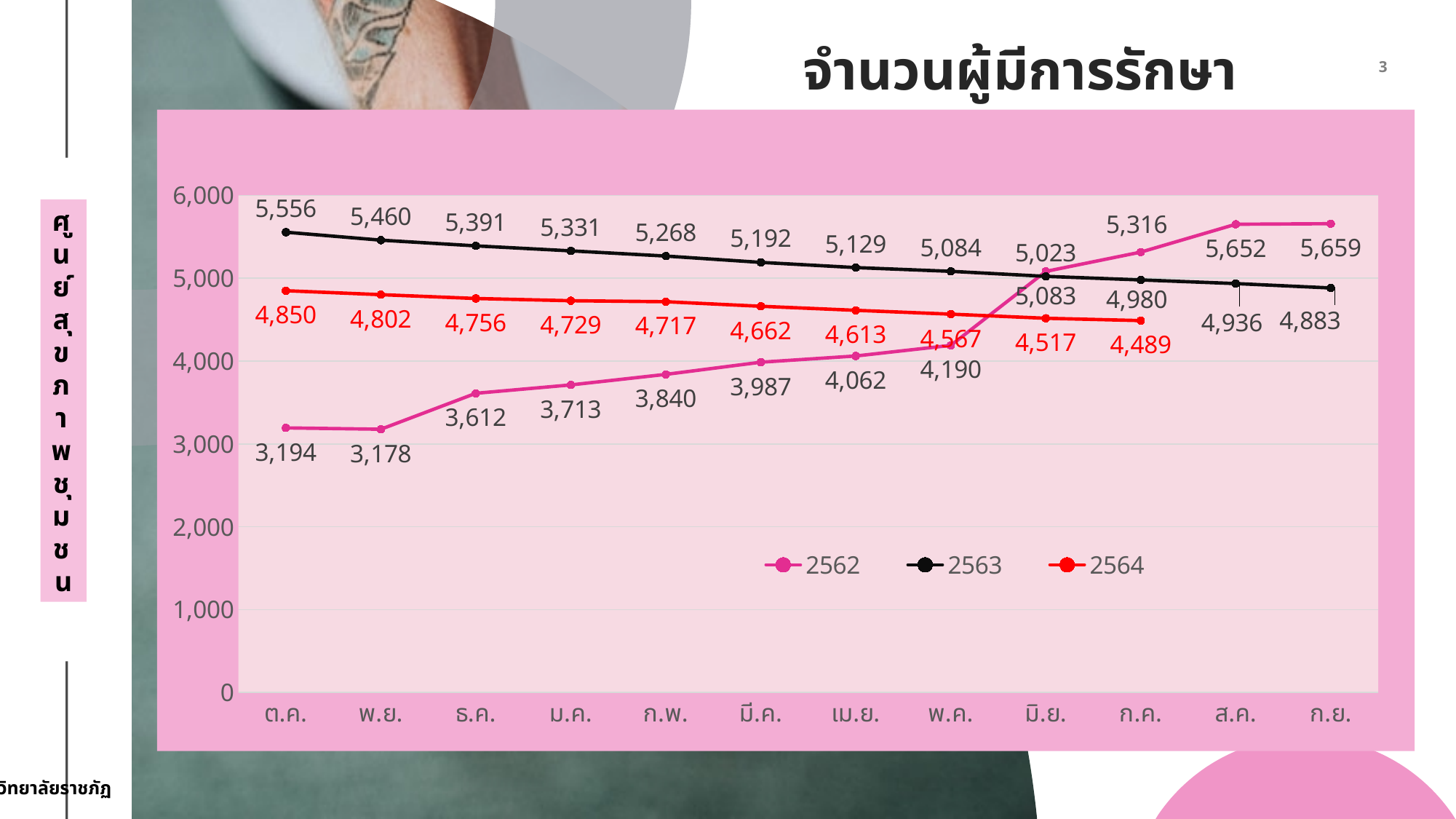
What is the value for the 2564 series in ก.ค.? 4,489 What is the value for the 2563 series in ต.ค.? 5,556 What is the value for the 2562 series in ก.ย.? 5,659 What is the title of the chart? จำนวนผู้มีการรักษา What is the difference between the 2563 and 2564 values in ต.ค.? 706 How many series does the legend list? 3 Which is larger in มิ.ย., the 2562 value or the 2563 value? 2562 Which month has the highest value for the 2563 series? ต.ค. Does the 2563 series rise or fall from ต.ค. to ก.ย.? fall Which month has the lowest value for the 2562 series? พ.ย. What kind of chart is shown on the slide? line chart How many months are shown on the x axis? 12